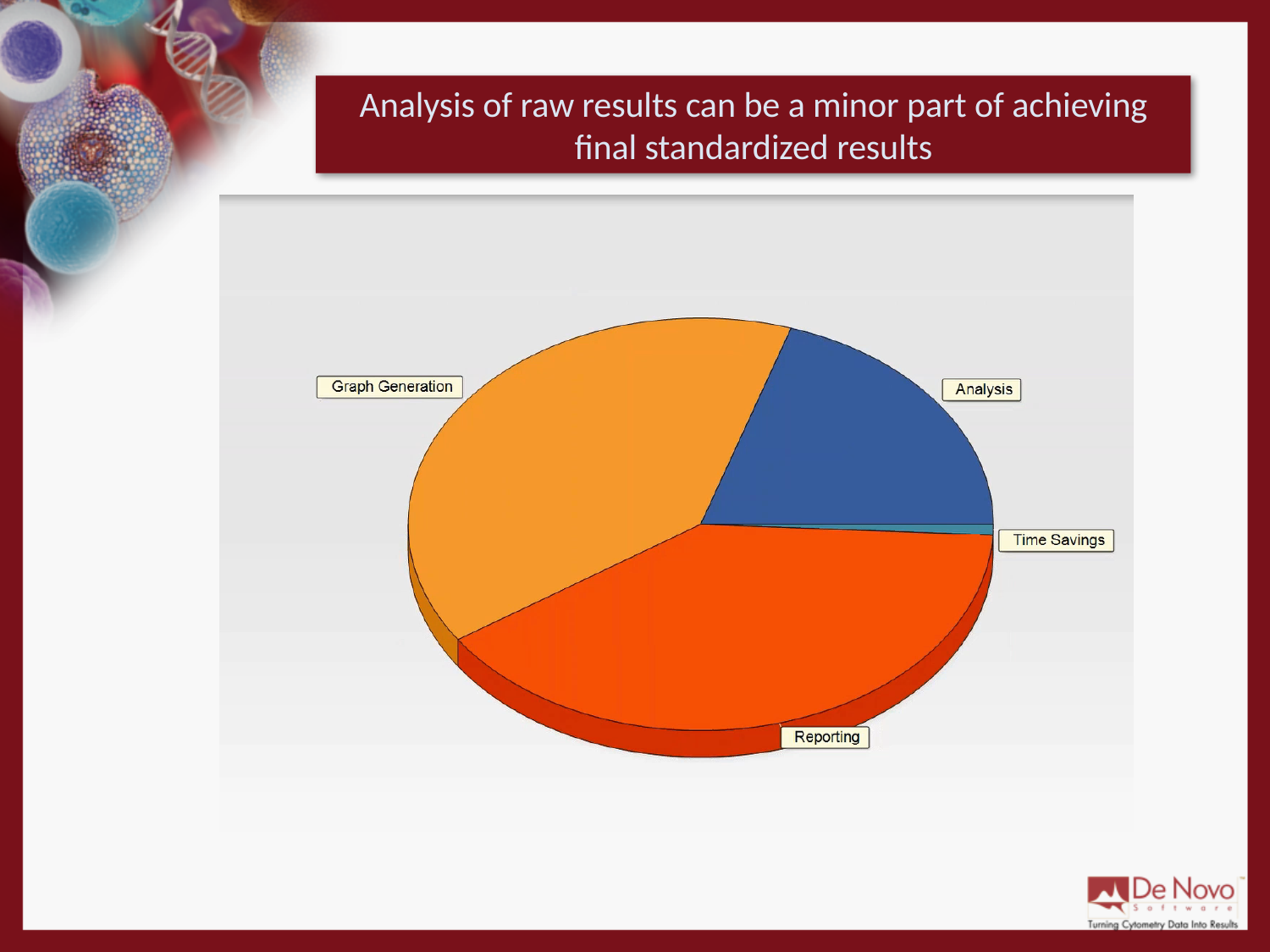
Which slice of the pie chart is the smallest? Time Savings Which slice is larger, Time Savings or Analysis? Analysis Which slice is larger, Analysis or Graph Generation? Graph Generation Which slice is larger, Time Savings or Reporting? Reporting What is the title of the slide containing the pie chart? Analysis of raw results can be a minor part of achieving final standardized results How many slices does the pie chart have? 4 What kind of chart is shown on the slide? Pie chart What colour is the Analysis slice of the pie chart? Blue